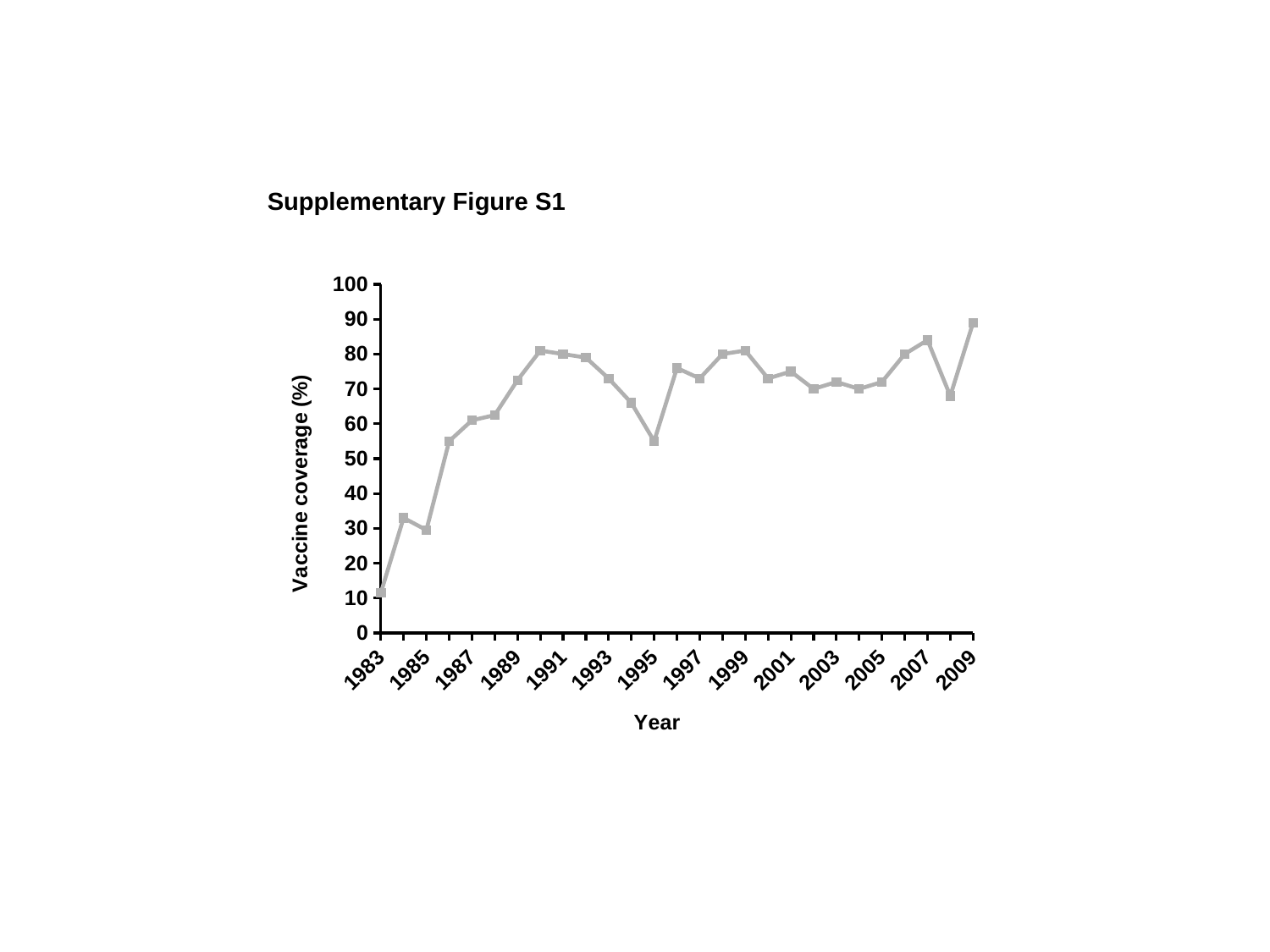
Which year has the highest vaccine coverage? 2009 Is the vaccine coverage for 1985 greater or less than 40? less Which year has higher vaccine coverage, 1995 or 1997? 1997 What is the label of the vertical axis? Vaccine coverage (%) Does vaccine coverage rise or fall from 1993 to 1995? fall Is the vaccine coverage for 1987 greater or less than 50? greater Does vaccine coverage rise or fall from 1983 to 1990? rise Is the vaccine coverage for 1983 greater or less than 20? less What kind of chart is shown on the slide? line chart Which year has the lowest vaccine coverage? 1983 What is the title of the figure on the slide? Supplementary Figure S1